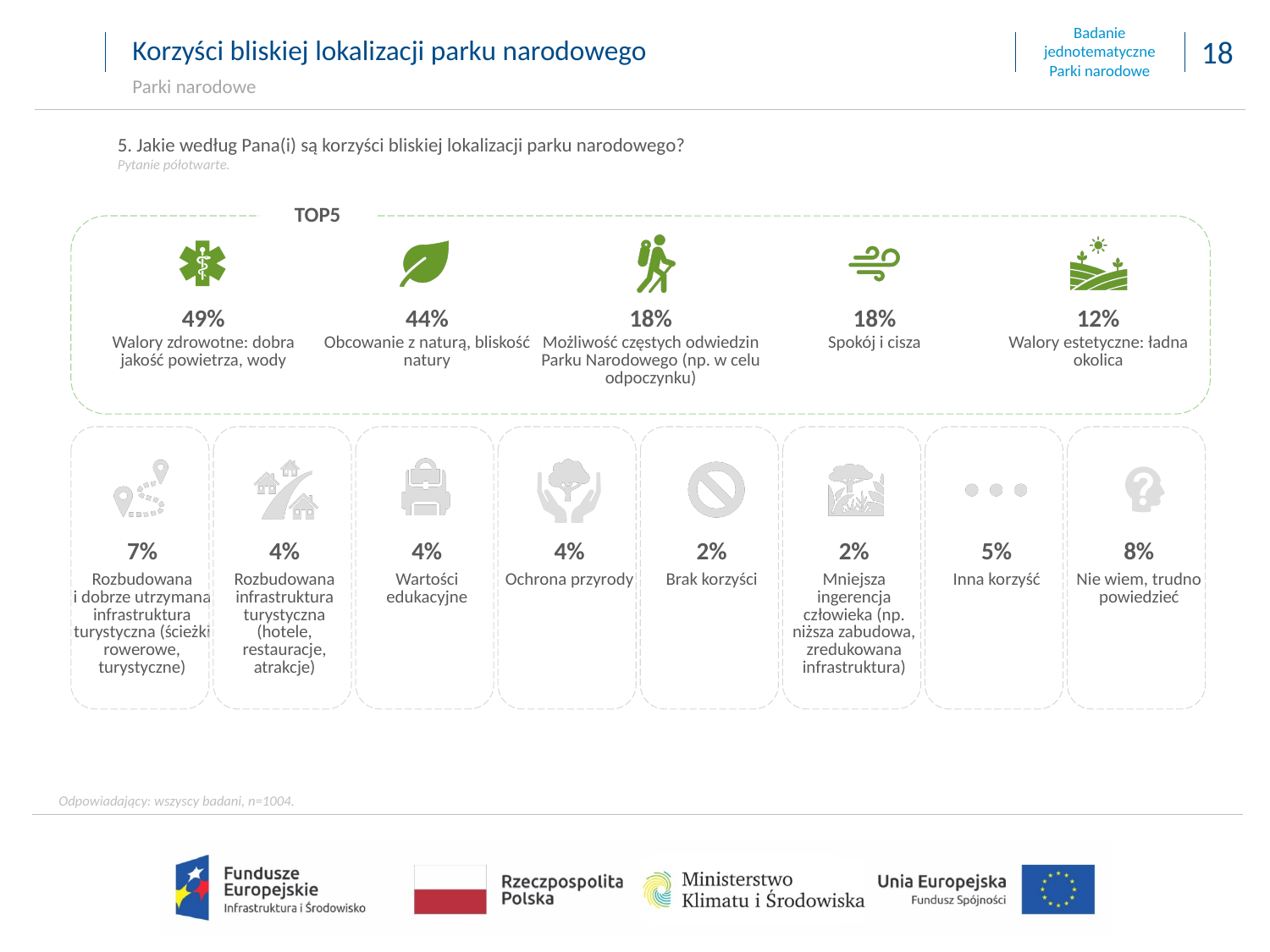
Which benefit has the highest percentage on the slide? Walory zdrowotne: dobra jakość powietrza, wody How many categories are shown in the TOP5 section? 5 What percentage is shown for 'Brak korzyści'? 2% What percentage of respondents named 'Walory zdrowotne: dobra jakość powietrza, wody' as a benefit of living near a national park? 49% What percentage is shown for 'Spokój i cisza'? 18% How many response categories are shown in total on the slide (TOP5 plus the lower row)? 13 What is the lowest percentage value shown among the categories? 2% What is the difference in percentage points between 'Walory zdrowotne' (49%) and 'Obcowanie z naturą' (44%)? 5 percentage points What is the sample size (n) stated at the bottom of the slide? n=1004 What value is shown for 'Nie wiem, trudno powiedzieć'? 8% What is the value shown for 'Obcowanie z naturą, bliskość natury'? 44% Which has a higher value: 'Spokój i cisza' or 'Walory estetyczne: ładna okolica'? Spokój i cisza